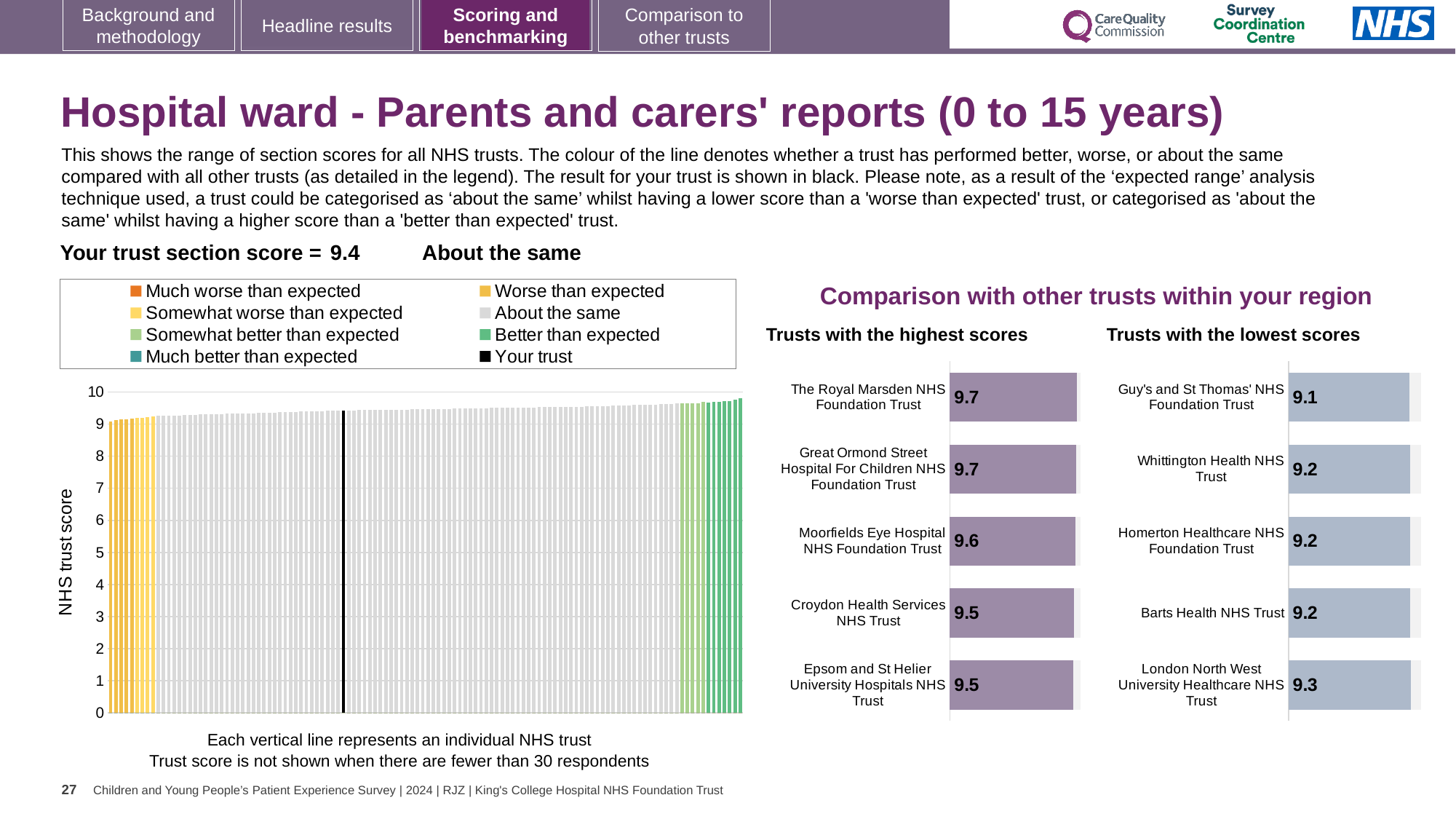
In the 'Trusts with the lowest scores' chart, what is the difference between the scores of London North West University Healthcare NHS Trust and Guy's and St Thomas' NHS Foundation Trust? 0.2 What is the section score for your trust shown on the slide? 9.4 In the 'Trusts with the highest scores' chart, what is the score for The Royal Marsden NHS Foundation Trust? 9.7 In the 'Trusts with the lowest scores' chart, which trust has the lowest score? Guy's and St Thomas' NHS Foundation Trust How many trusts are shown in the 'Trusts with the highest scores' chart? 5 In the 'Trusts with the highest scores' chart, what is the score for Moorfields Eye Hospital NHS Foundation Trust? 9.6 In the 'Trusts with the lowest scores' chart, what is the score for Guy's and St Thomas' NHS Foundation Trust? 9.1 In the 'Trusts with the highest scores' chart, what is the difference between the scores of The Royal Marsden NHS Foundation Trust and Epsom and St Helier University Hospitals NHS Trust? 0.2 In the 'Trusts with the lowest scores' chart, what is the score for London North West University Healthcare NHS Trust? 9.3 What kind of chart is the large chart on the left showing NHS trust scores? bar chart How many entries does the legend above the left-hand NHS trust score chart list? 8 Comparing the two regional charts, which has the higher score: Croydon Health Services NHS Trust or Barts Health NHS Trust? Croydon Health Services NHS Trust